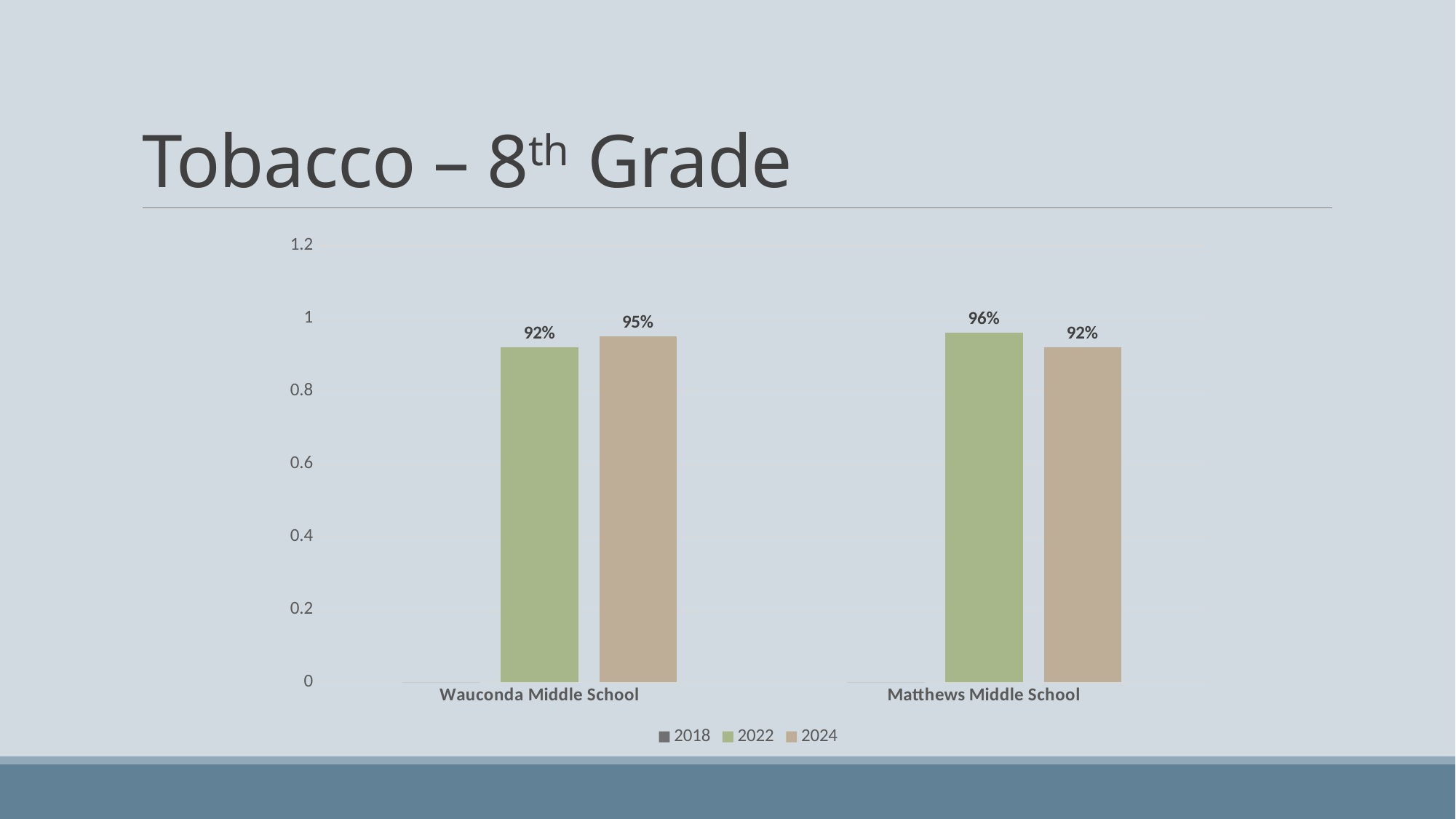
What is the difference between the 2022 and 2024 values for Matthews Middle School? 4% What is the title of the slide? Tobacco – 8th Grade How many series does the legend list? 3 What is the 2024 value for Wauconda Middle School? 95% What is the 2022 value for Wauconda Middle School? 92% Which school has the higher 2024 value? Wauconda Middle School What is the 2024 value for Matthews Middle School? 92% What kind of chart is shown on the slide? Bar chart What is the 2022 value for Matthews Middle School? 96% How many schools are shown on the x axis? 2 What is the difference between the 2024 and 2022 values for Wauconda Middle School? 3% Which school has the higher 2022 value? Matthews Middle School